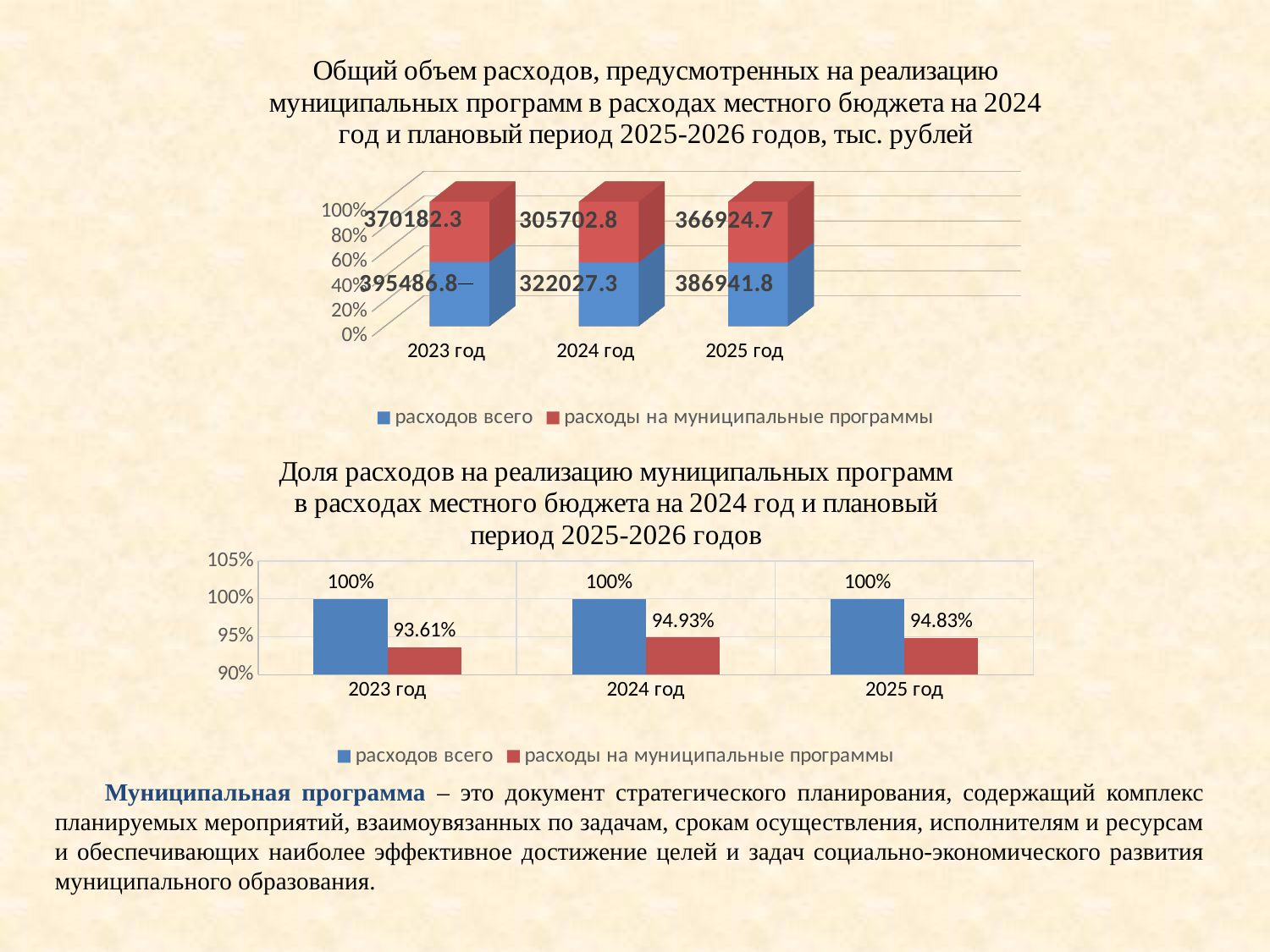
In the top chart, what is the value of 'расходы на муниципальные программы' for 2024 год? 305702.8 In the top chart, how many series does the legend list? 2 In the top chart, what is the value of 'расходы на муниципальные программы' for 2025 год? 366924.7 In the bottom chart, what is the value of 'расходы на муниципальные программы' for 2024 год? 94.93% In the bottom chart, which year has the lowest value for 'расходы на муниципальные программы'? 2023 год In the bottom chart, how many years are shown on the x axis? 3 In the top chart, what is the value of 'расходов всего' for 2023 год? 395486.8 In the top chart, which year has the highest value for 'расходов всего'? 2023 год What kind of chart is the bottom chart? bar chart In the top chart, what is the difference between 'расходов всего' and 'расходы на муниципальные программы' for 2023 год? 25304.5 In the top chart, which year has the lowest value for 'расходы на муниципальные программы'? 2024 год In the bottom chart, what is the value of 'расходы на муниципальные программы' for 2023 год? 93.61%